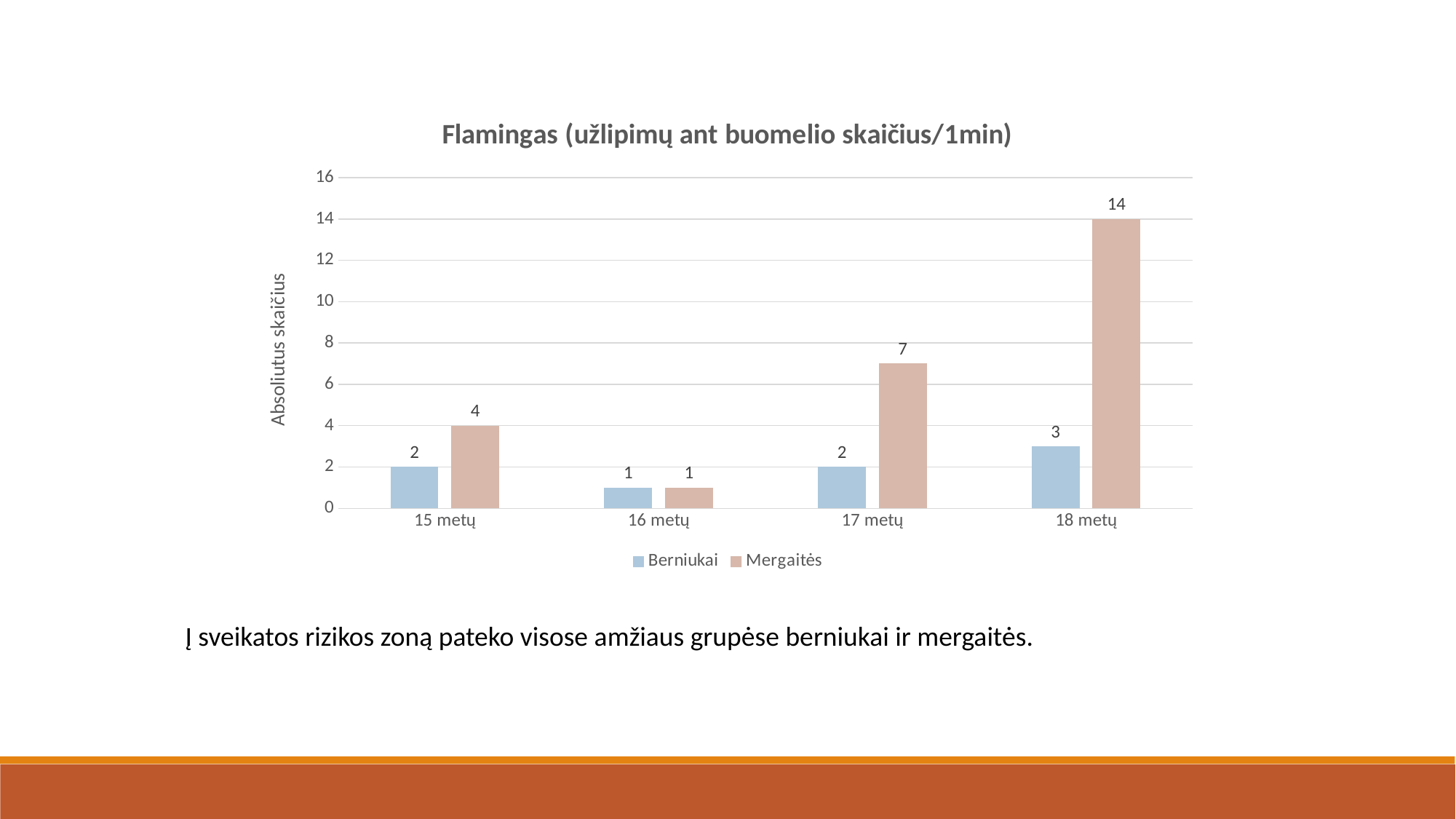
Do the Mergaitės values rise or fall from 16 metų to 18 metų? Rise Which age group has the highest value for Mergaitės? 18 metų How many series does the legend list? 2 What is the value for Mergaitės at 17 metų? 7 What kind of chart is shown on the slide? Bar chart How many age groups are shown on the x axis? 4 What is the value for Mergaitės at 18 metų? 14 What is the value for Berniukai at 15 metų? 2 What is the title of the chart? Flamingas (užlipimų ant buomelio skaičius/1min) Which age group has the lowest value for Berniukai? 16 metų What is the difference between Mergaitės and Berniukai at 18 metų? 11 Which is larger at 17 metų, Berniukai or Mergaitės? Mergaitės